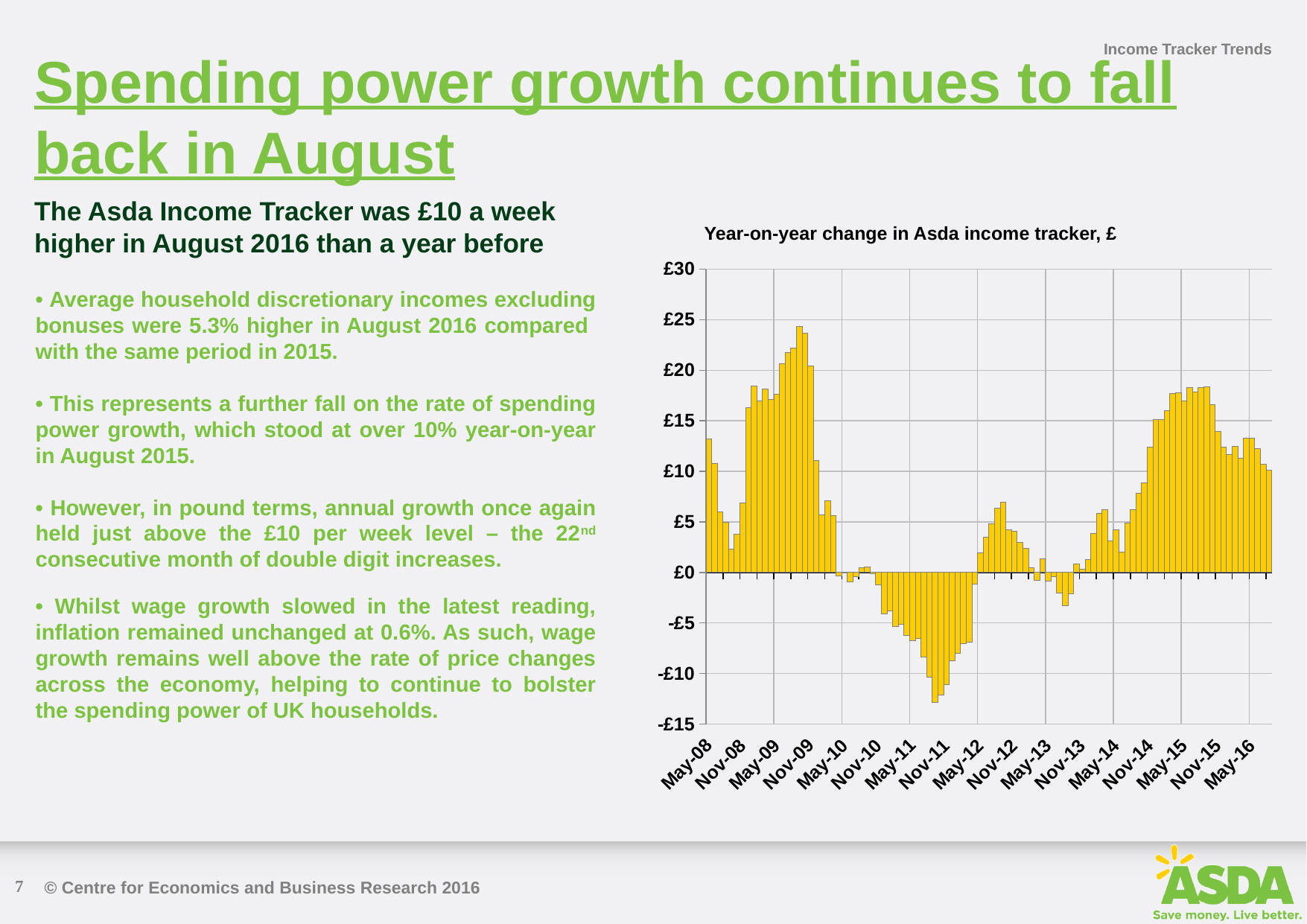
Do the values rise or fall between May-09 and Nov-09? Rise Is the value for May-08 greater or less than £10? greater Is the value for May-11 greater or less than -£5? less What is the highest value shown on the y axis of the chart? £30 Is the value for Nov-11 greater or less than -£10? less What is the title of the chart? Year-on-year change in Asda income tracker, £ Which is larger, the value for Nov-09 or the value for Nov-11? Nov-09 What kind of chart is shown on the slide? Bar chart How many date labels are shown on the x axis of the chart? 17